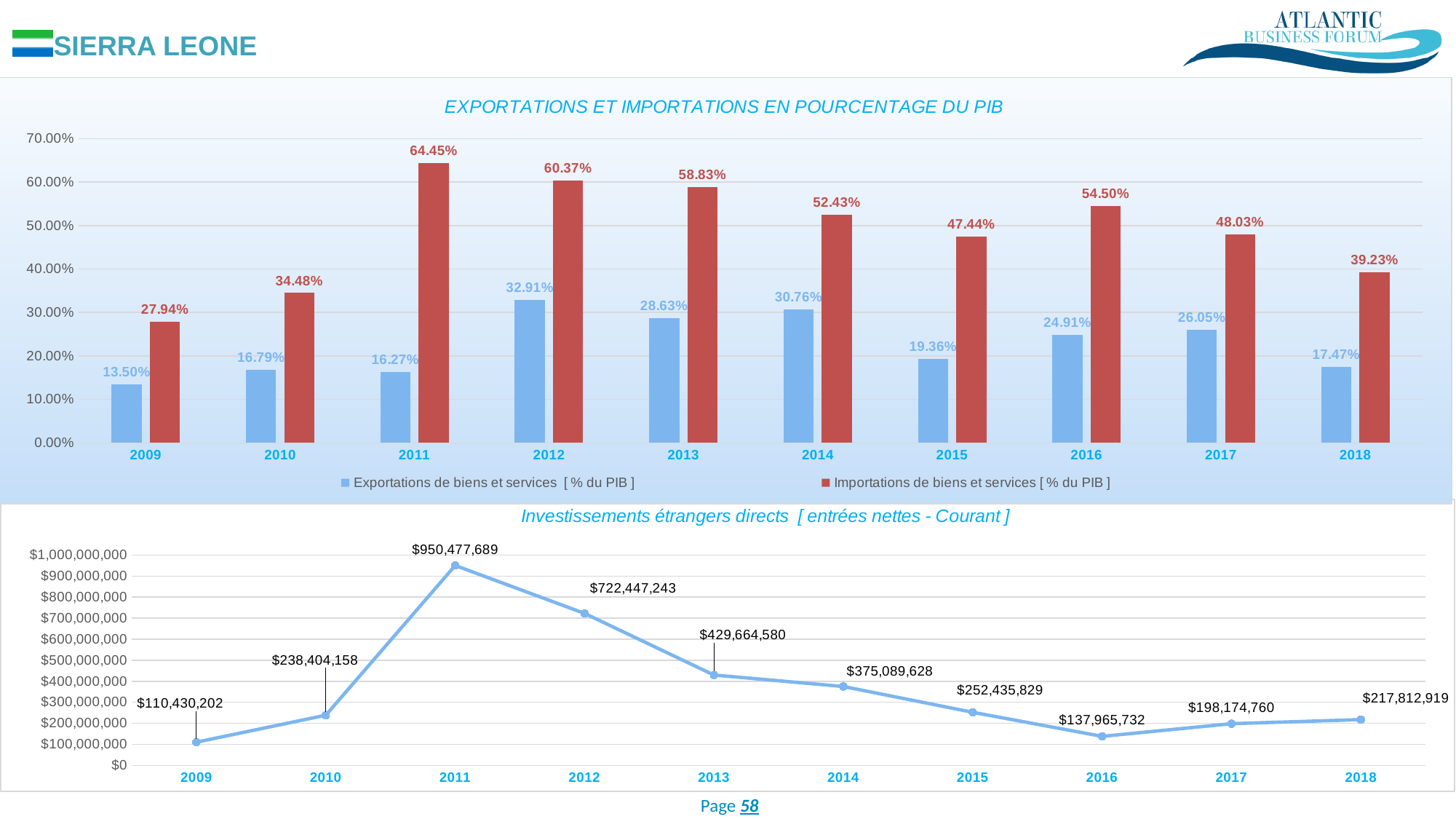
In the top chart 'EXPORTATIONS ET IMPORTATIONS EN POURCENTAGE DU PIB', which year has the lowest Exportations value? 2009 In the top chart 'EXPORTATIONS ET IMPORTATIONS EN POURCENTAGE DU PIB', how many series does the legend list? 2 In the top chart 'EXPORTATIONS ET IMPORTATIONS EN POURCENTAGE DU PIB', what is the value of Importations de biens et services for 2016? 54.50% In the top chart 'EXPORTATIONS ET IMPORTATIONS EN POURCENTAGE DU PIB', what kind of chart is shown? Bar chart In the top chart 'EXPORTATIONS ET IMPORTATIONS EN POURCENTAGE DU PIB', what is the value of Exportations de biens et services for 2012? 32.91% In the bottom chart 'Investissements étrangers directs', which year has the highest value? 2011 In the top chart 'EXPORTATIONS ET IMPORTATIONS EN POURCENTAGE DU PIB', which year has the highest Importations value? 2011 In the bottom chart 'Investissements étrangers directs', which year has the lowest value? 2009 In the bottom chart 'Investissements étrangers directs', what is the value for 2013? $429,664,580 In the top chart 'EXPORTATIONS ET IMPORTATIONS EN POURCENTAGE DU PIB', what is the difference between Importations and Exportations in 2011? 48.18% In the bottom chart 'Investissements étrangers directs', is the value for 2016 larger or smaller than the value for 2017? Smaller In the bottom chart 'Investissements étrangers directs', how many years are plotted? 10